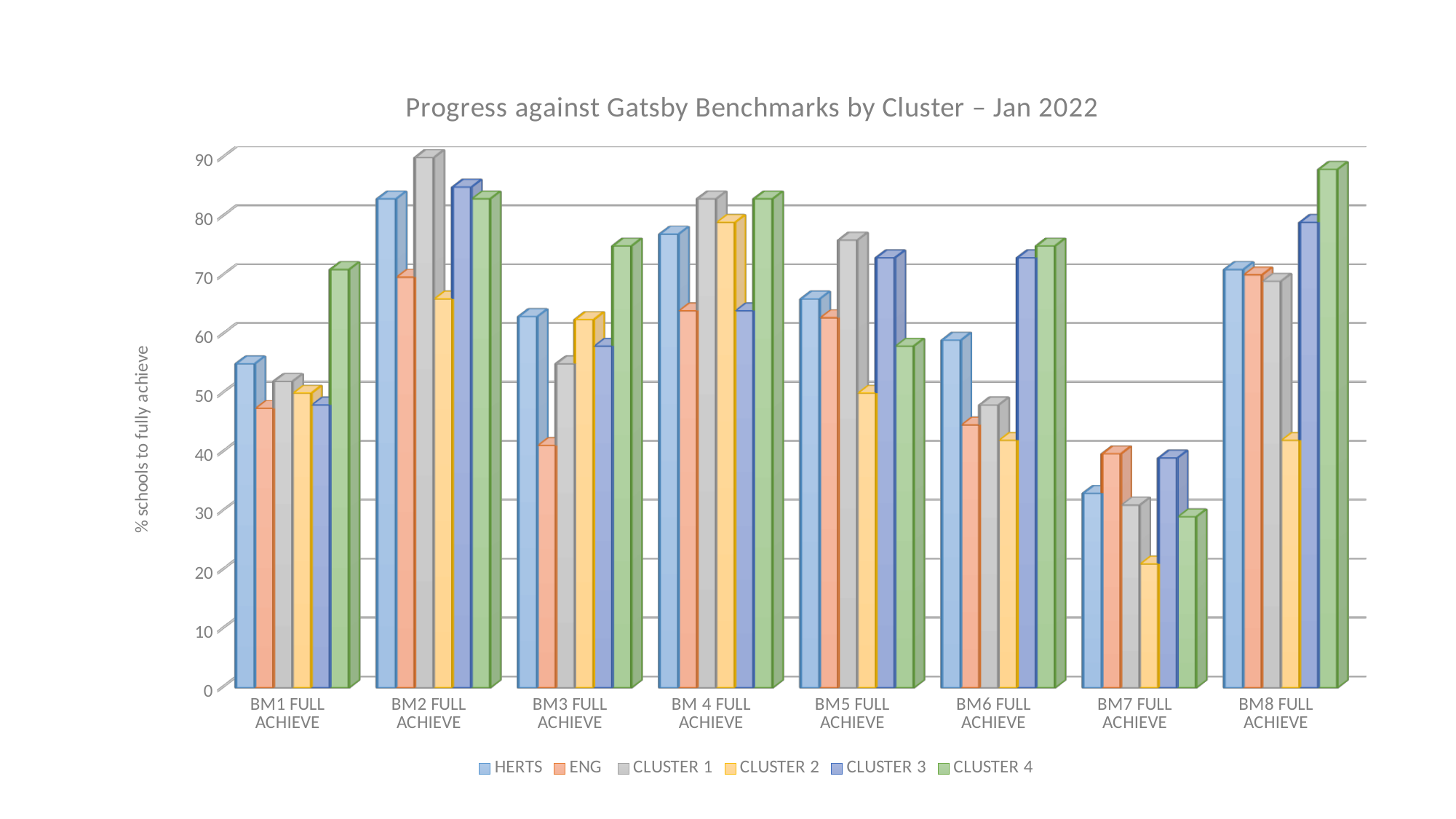
Is the value for CLUSTER 1 at BM2 FULL ACHIEVE greater or less than 80? greater Which series has the lowest value for BM7 FULL ACHIEVE? CLUSTER 2 Which series has the highest value for BM8 FULL ACHIEVE? CLUSTER 4 For BM3 FULL ACHIEVE, which is larger: HERTS or ENG? HERTS Which series has the lowest value for BM3 FULL ACHIEVE? ENG How many benchmark categories are shown on the x axis? 8 What is the title of the chart? Progress against Gatsby Benchmarks by Cluster – Jan 2022 How many series does the legend list? 6 What type of chart is shown on the slide? Bar chart What is the label on the vertical axis? % schools to fully achieve Is the value for CLUSTER 2 at BM7 FULL ACHIEVE greater or less than 30? less Which series has the highest value for BM2 FULL ACHIEVE? CLUSTER 1